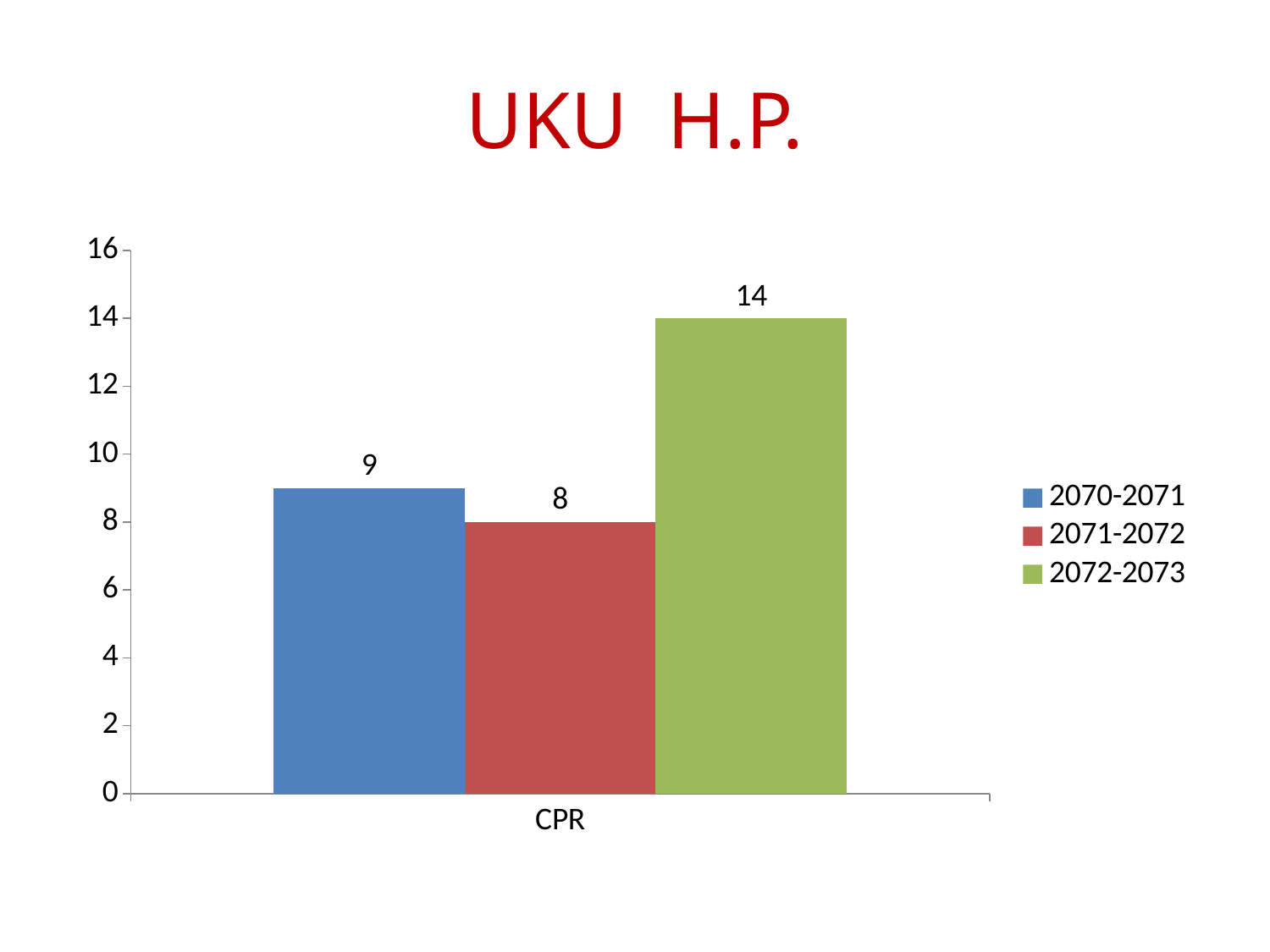
What is the CPR value for 2070-2071? 9 How many series does the legend list? 3 What is the difference between the CPR values for 2072-2073 and 2070-2071? 5 Is the CPR value for 2072-2073 greater or less than 12? greater What is the difference between the CPR values for 2070-2071 and 2071-2072? 1 Which series has the lowest CPR value? 2071-2072 What is the CPR value for 2072-2073? 14 What is the CPR value for 2071-2072? 8 Which is larger, the CPR value for 2070-2071 or for 2071-2072? 2070-2071 What kind of chart is shown on the slide? bar chart What is the title of the slide? UKU H.P. Which series has the highest CPR value? 2072-2073